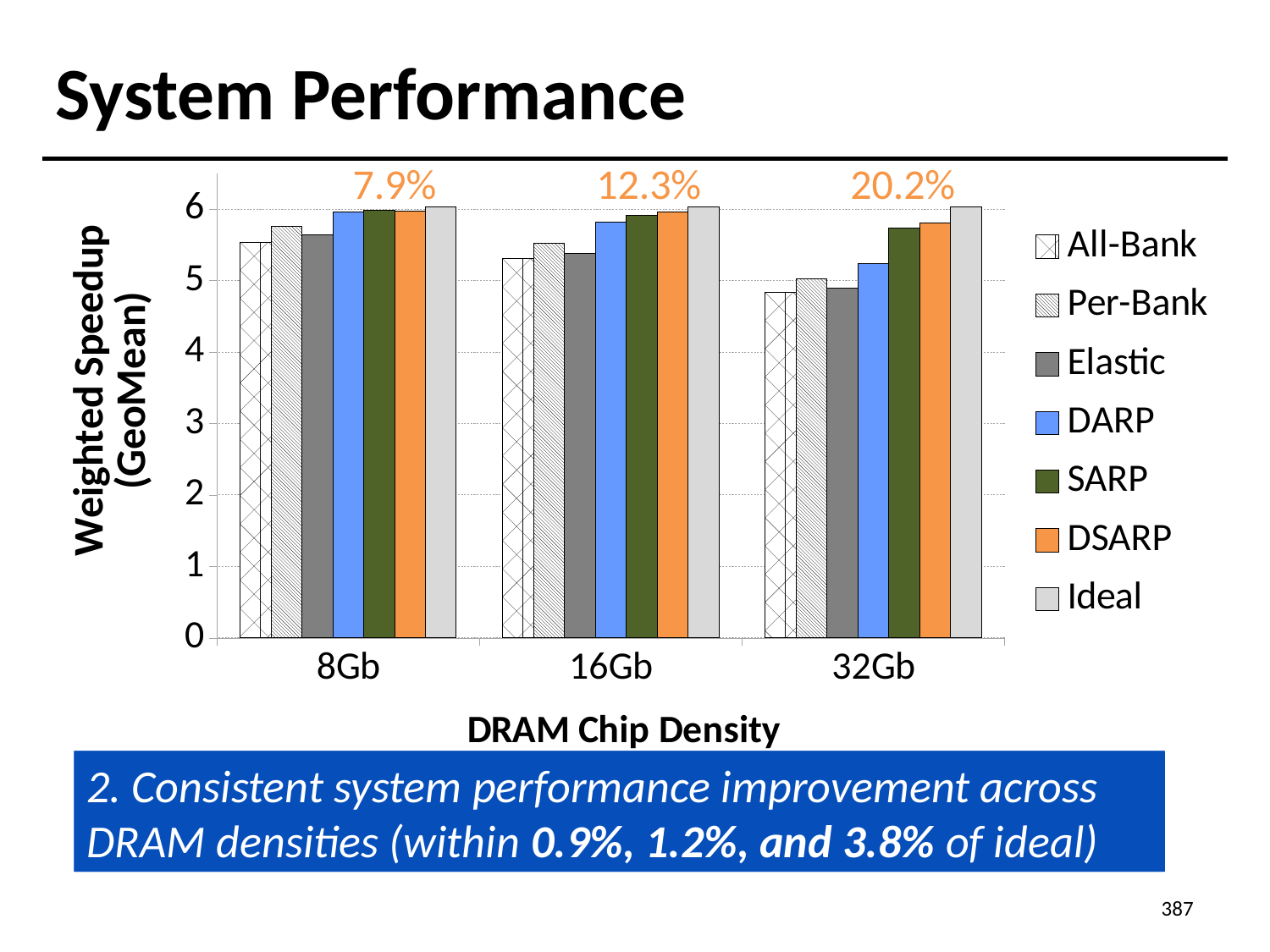
Is the value for All-Bank at 8Gb greater or less than 5? greater What percentage is printed above the 32Gb group of bars? 20.2% What is the title of the y axis? Weighted Speedup (GeoMean) Is the value for DARP at 32Gb greater or less than 5? greater How many series does the legend list? 7 At 32Gb, which is larger, the value for DARP or the value for Elastic? DARP Do the All-Bank values rise or fall as DRAM chip density increases from 8Gb to 32Gb? fall At 32Gb, which is larger, the value for Ideal or the value for All-Bank? Ideal Is the value for All-Bank at 32Gb greater or less than 5? less How many DRAM chip density categories are shown on the x axis? 3 What kind of chart is shown on the slide? bar chart Which series has the highest value at 32Gb? Ideal